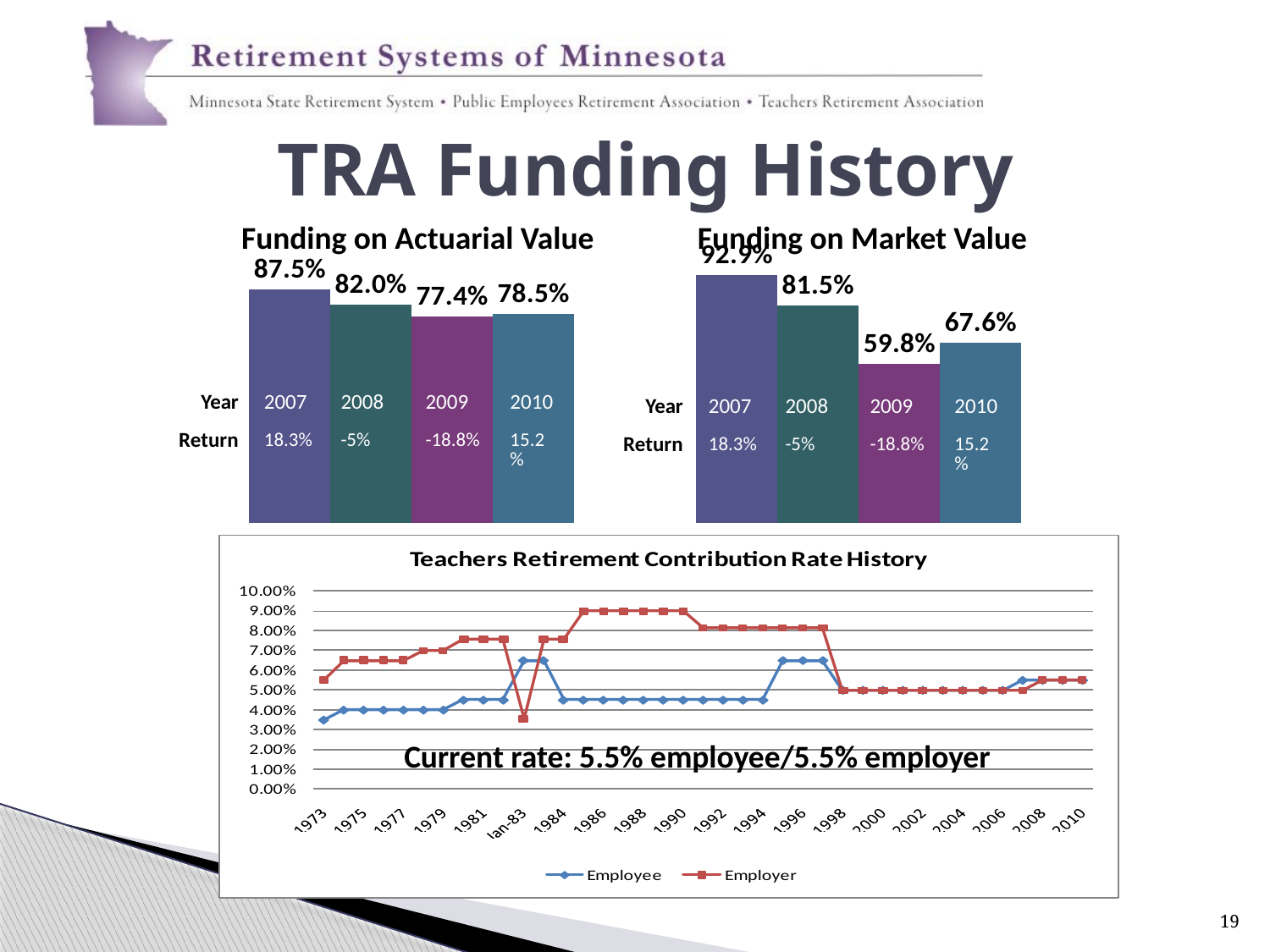
In the Teachers Retirement Contribution Rate History chart, is the Employee rate for 1973 greater or less than 4.00%? less In the Funding on Actuarial Value chart, what is the difference between the 2008 and 2009 funding values? 4.6% In the Funding on Actuarial Value chart, what is the funding value for 2007? 87.5% What kind of chart is the Teachers Retirement Contribution Rate History chart? line chart How many series does the legend of the Teachers Retirement Contribution Rate History chart list? 2 In the Funding on Market Value chart, what is the funding value for 2009? 59.8% In the Funding on Market Value chart, which year has the highest funding value? 2007 In the Teachers Retirement Contribution Rate History chart, is the Employer rate for 1988 greater or less than 8.00%? greater In the Funding on Market Value chart, what is the difference between the 2007 and 2010 funding values? 25.3% In the Funding on Market Value chart, is the funding value for 2008 larger or smaller than the value for 2010? larger How many years are shown in the Funding on Actuarial Value chart? 4 In the Funding on Actuarial Value chart, which year has the lowest funding value? 2009